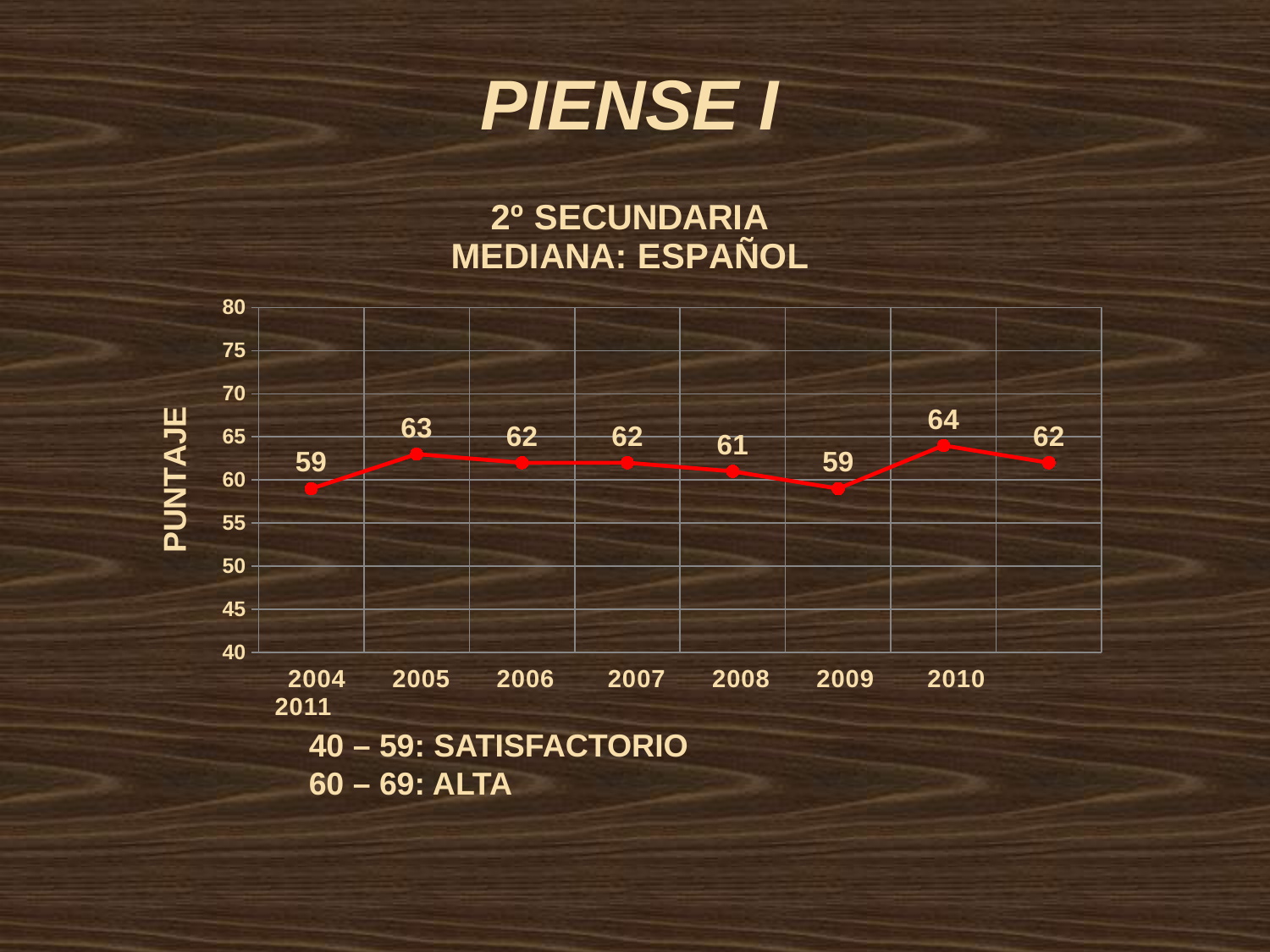
Which year has the highest PUNTAJE value? 2010 How many data points are plotted on the line? 8 What is the PUNTAJE value for 2009? 59 What is the label on the vertical axis of the chart? PUNTAJE Which year has a larger PUNTAJE value, 2005 or 2008? 2005 What is the PUNTAJE value for 2005? 63 What is the lowest PUNTAJE value plotted on the chart? 59 What is the PUNTAJE value for 2008? 61 Is the PUNTAJE value for 2004 greater or less than 60? less Does the PUNTAJE value rise or fall from 2004 to 2005? rise What type of chart is shown on the slide? line chart What is the difference between the PUNTAJE values for 2010 and 2009? 5